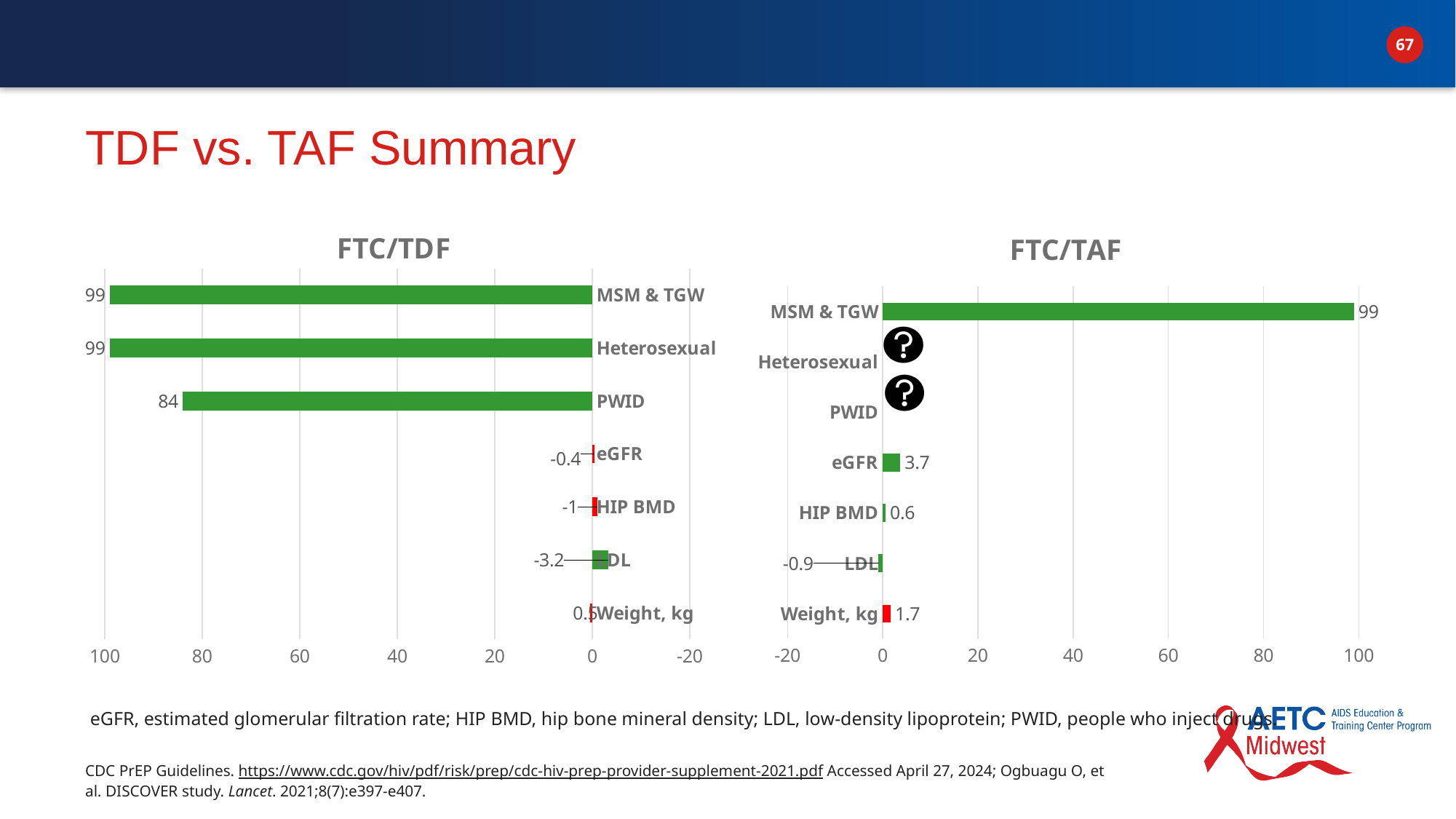
In the FTC/TAF chart, which category has the highest value? MSM & TGW In the FTC/TAF chart, what is the value for Weight, kg? 1.7 In the FTC/TDF chart, what is the value for LDL? -3.2 In the FTC/TDF chart, what is the value for PWID? 84 In the FTC/TDF chart, which category has the lowest value? LDL How many categories are shown in the FTC/TDF chart? 7 In the FTC/TAF chart, which categories are marked with a question mark instead of a bar? Heterosexual and PWID In the FTC/TAF chart, what is the value for eGFR? 3.7 In the FTC/TAF chart, which is larger, the value for eGFR or the value for HIP BMD? eGFR In the FTC/TDF chart, what is the difference between the values for MSM & TGW and PWID? 15 In the FTC/TDF chart, what is the value for HIP BMD? -1 What kind of chart is the FTC/TAF chart? Bar chart